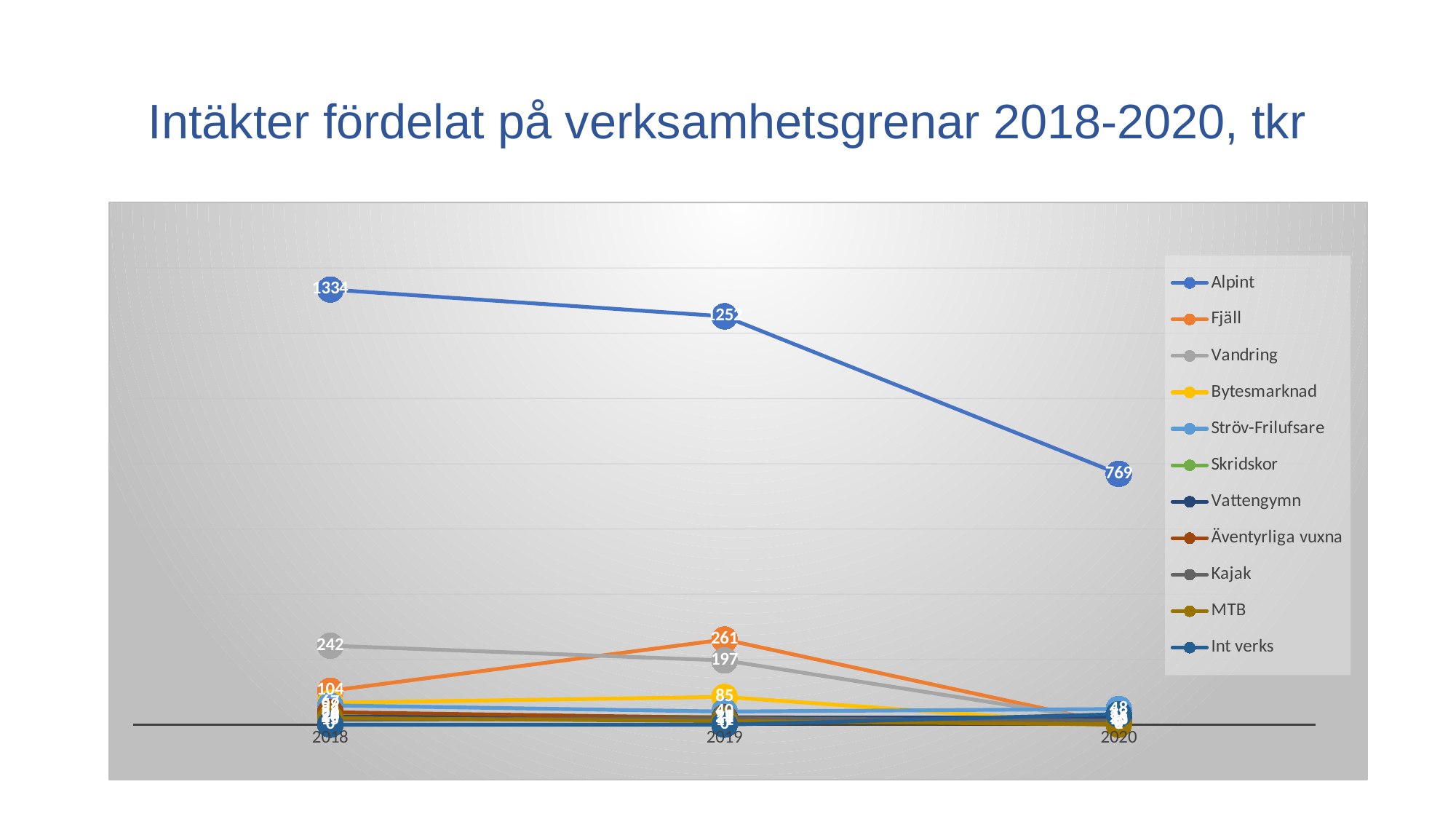
What is the value for Fjäll in 2019? 261 What is the difference between the Fjäll values in 2019 and 2018? 157 What is the value for Alpint in 2018? 1334 What is the value for Bytesmarknad in 2019? 85 How many series does the legend list? 11 Does the Alpint line rise or fall from 2018 to 2020? fall By how much did the Alpint value fall from 2018 to 2020? 565 Which series has the highest value in 2018? Alpint What is the value for Vandring in 2018? 242 In 2019, which is larger: Fjäll or Vandring? Fjäll What is the value for Alpint in 2020? 769 What kind of chart is shown on the slide? line chart